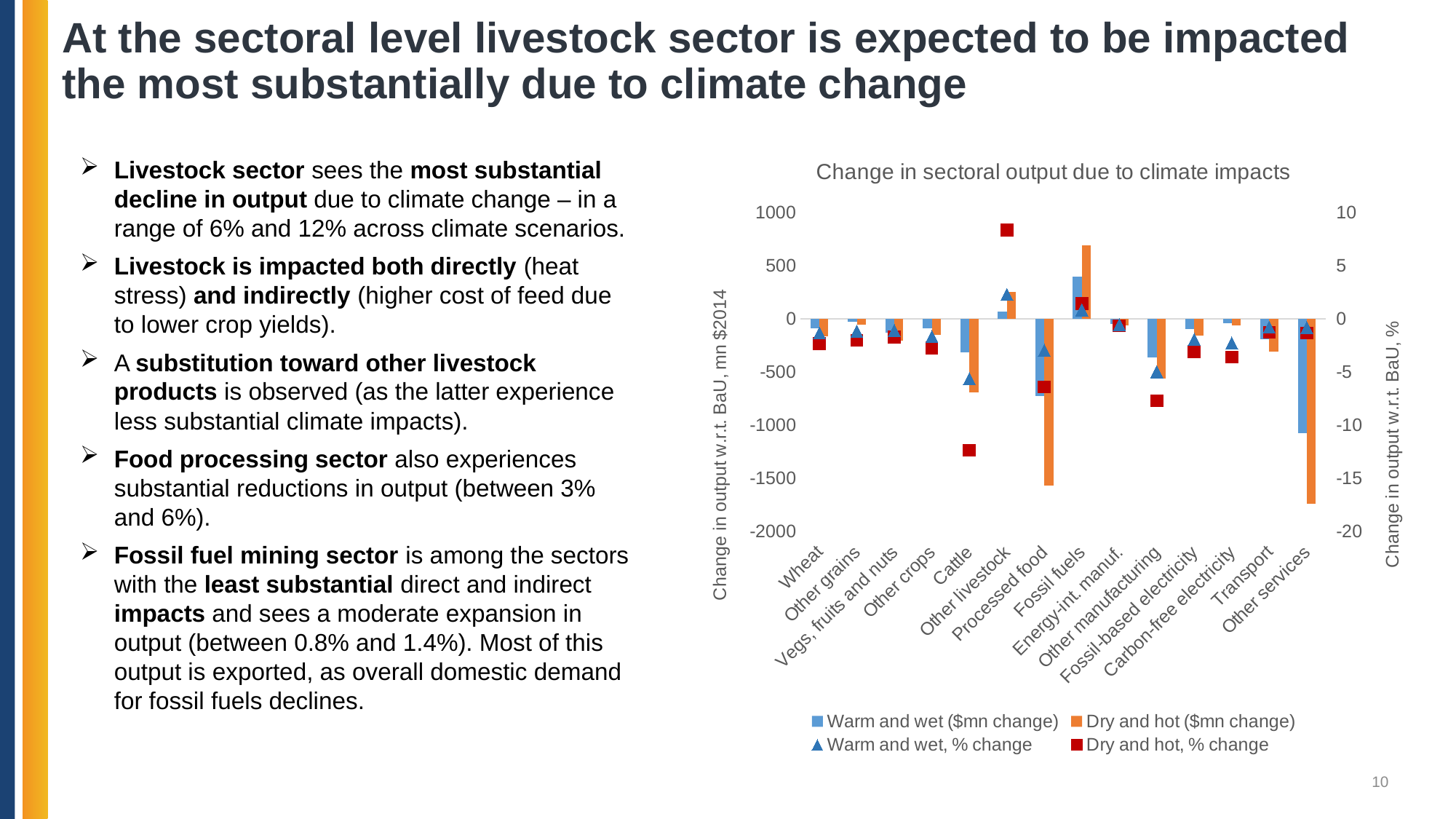
How many series does the chart's legend list? 4 Is the Dry and hot, % change value for Cattle greater or less than -10? less For Fossil fuels, which is larger: the Warm and wet ($mn change) bar or the Dry and hot ($mn change) bar? Dry and hot ($mn change) Which sector has the lowest Dry and hot, % change marker? Cattle How many sectors (categories) are shown on the x axis of the chart? 14 Which sector has the highest Dry and hot, % change marker? Other livestock Is the Dry and hot ($mn change) value for Other services greater or less than -1500? less Is the Dry and hot ($mn change) value for Fossil fuels greater or less than 500? greater Which sector has the highest Dry and hot ($mn change) bar? Fossil fuels What is the title of the chart? Change in sectoral output due to climate impacts What is the label of the right-hand vertical axis? Change in output w.r.t. BaU, % What kind of chart is shown on the slide? Combination chart of bars and scatter markers